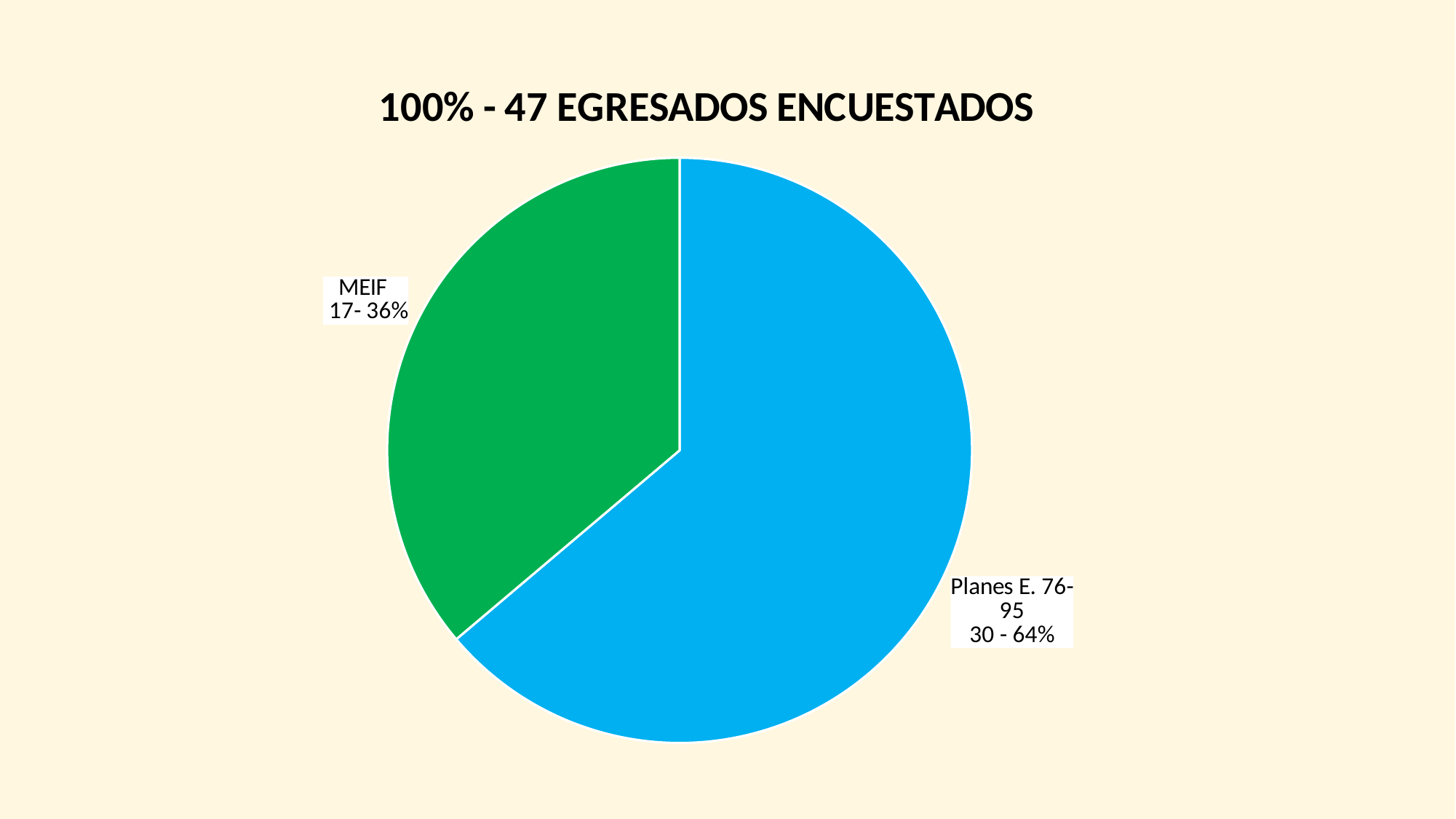
What percentage share does the MEIF slice represent? 36% Which slice is the largest? Planes E. 76-95 What colour is the MEIF slice? green How many graduates are in the MEIF slice? 17 What kind of chart is shown on the slide? pie chart What percentage share does the Planes E. 76-95 slice represent? 64% Which is larger, the MEIF slice or the Planes E. 76-95 slice? Planes E. 76-95 What is the title of the chart? 100% - 47 EGRESADOS ENCUESTADOS What is the difference in number of graduates between Planes E. 76-95 and MEIF? 13 Which slice is the smallest? MEIF How many slices does the pie chart have? 2 How many graduates are in the Planes E. 76-95 slice? 30